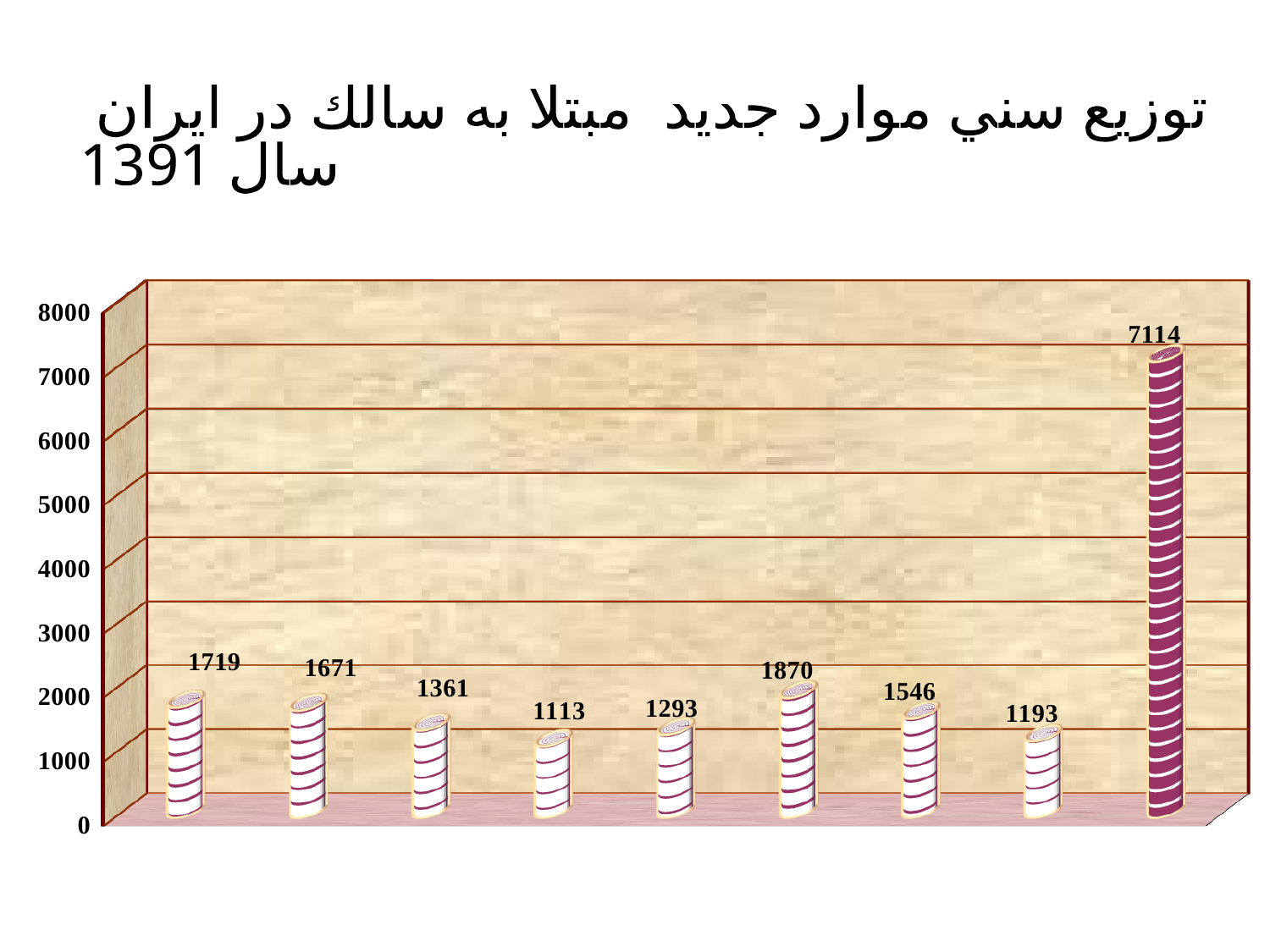
Which bar has the highest value? the rightmost (ninth) bar, 7114 What is the highest value labelled on the vertical axis? 8000 Which bar has the lowest value? the fourth bar from the left, 1113 What is the value shown on the leftmost (first) bar? 1719 How many bars are plotted in the chart? 9 What is the difference between the value of the rightmost bar (7114) and the first bar (1719)? 5395 Is the value of the sixth bar from the left greater or less than 2000? less Which is larger, the value of the second bar from the left or the seventh bar from the left? the second bar (1671) What is the value shown on the rightmost (ninth) bar? 7114 What is the value shown on the sixth bar from the left? 1870 What type of chart is shown on the slide? bar chart What is the value shown on the fourth bar from the left? 1113